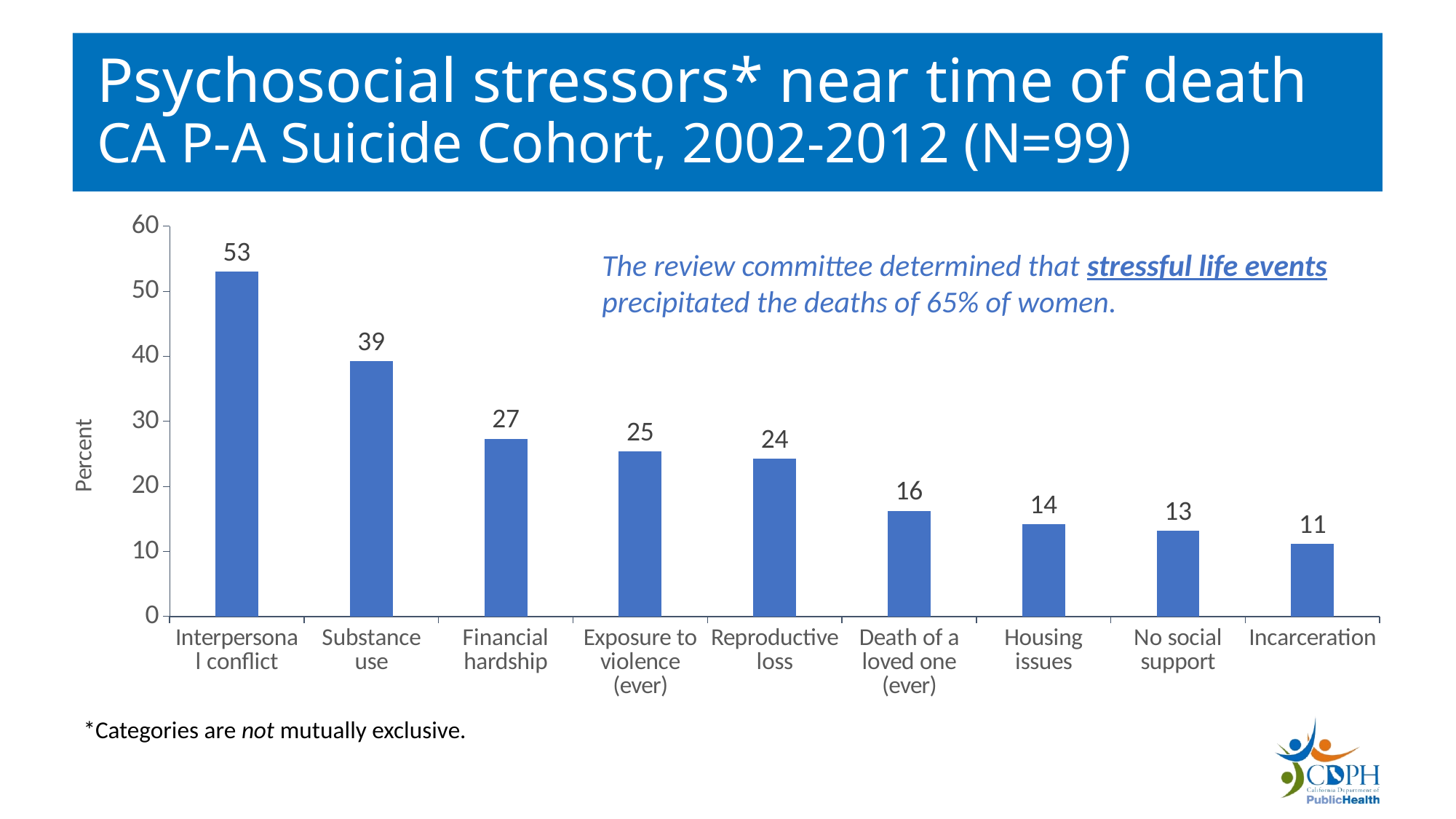
Which psychosocial stressor has the lowest percent? Incarceration What is the label on the vertical axis of the chart? Percent What percent of the cohort experienced interpersonal conflict near time of death? 53 What is the value shown for Substance use? 39 Which psychosocial stressor has the highest percent? Interpersonal conflict What kind of chart is shown on the slide? Bar chart What is the value shown for Reproductive loss? 24 What is the difference in percent between Interpersonal conflict and Substance use? 14 Is the value for Death of a loved one (ever) greater or less than 20? less How many psychosocial stressor categories are shown on the chart? 9 Which is larger, the value for Financial hardship or the value for Housing issues? Financial hardship What is the value shown for Incarceration? 11